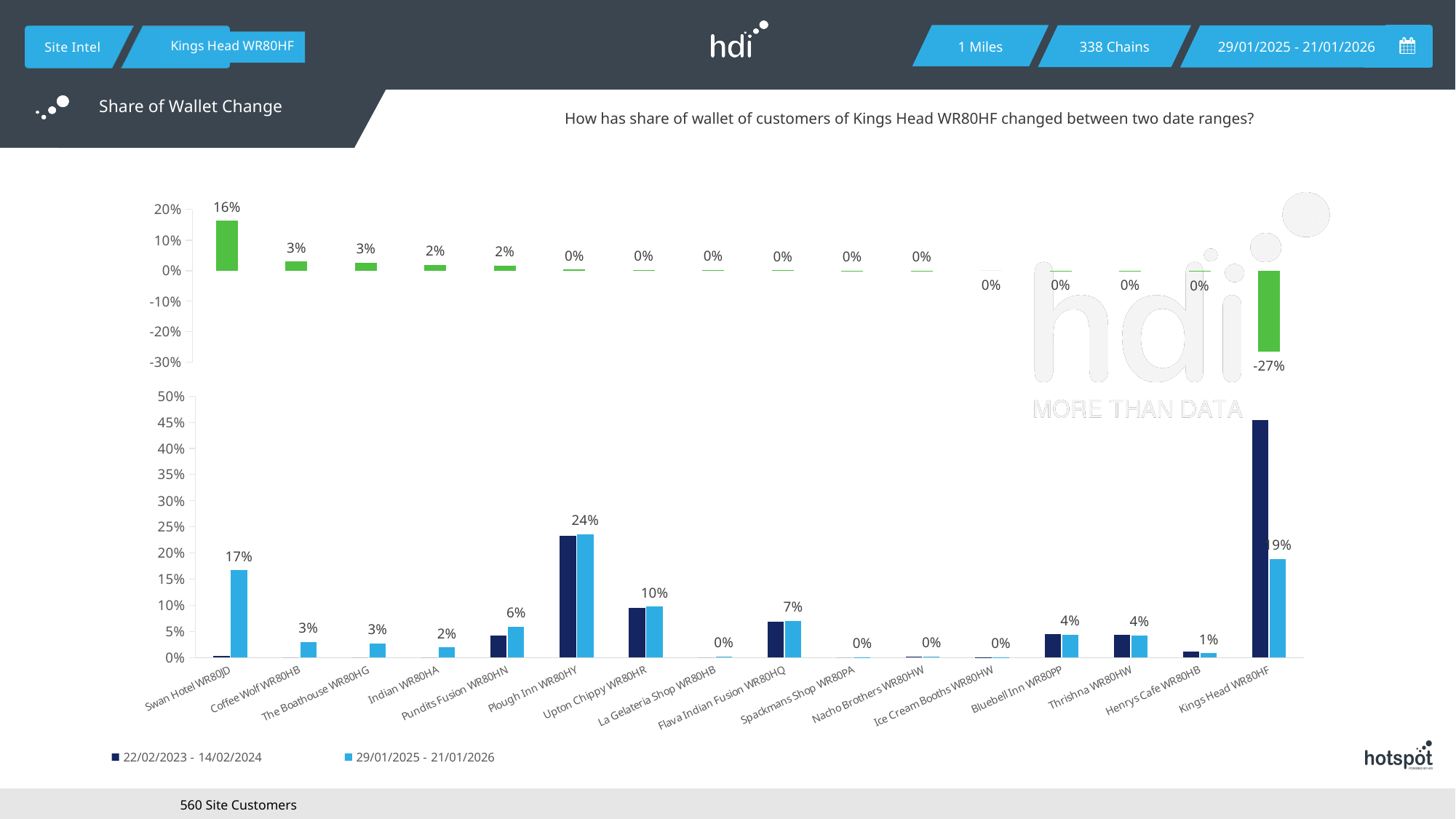
On the bottom chart, what is the value for Upton Chippy WR80HR in the 29/01/2025 - 21/01/2026 series? 10% On the top chart (share of wallet change), which category has the highest value? Swan Hotel WR80JD What kind of chart is the bottom chart on the slide? Bar chart On the top chart (share of wallet change), what is the value shown for Kings Head WR80HF? -27% On the top chart (share of wallet change), which category has the lowest value? Kings Head WR80HF How many categories are shown on the x axis of the bottom chart? 16 On the bottom chart, is the value for Kings Head WR80HF in the 22/02/2023 - 14/02/2024 series greater or less than 40%? greater On the bottom chart, what is the value for Plough Inn WR80HY in the 29/01/2025 - 21/01/2026 series? 24% On the top chart (share of wallet change), what is the value shown for Swan Hotel WR80JD? 16% How many series does the legend of the bottom chart list? 2 On the top chart (share of wallet change), what is the difference between the values for Swan Hotel WR80JD and Coffee Wolf WR80HB? 13% On the bottom chart, which is larger in the 29/01/2025 - 21/01/2026 series: Swan Hotel WR80JD or Flava Indian Fusion WR80HQ? Swan Hotel WR80JD